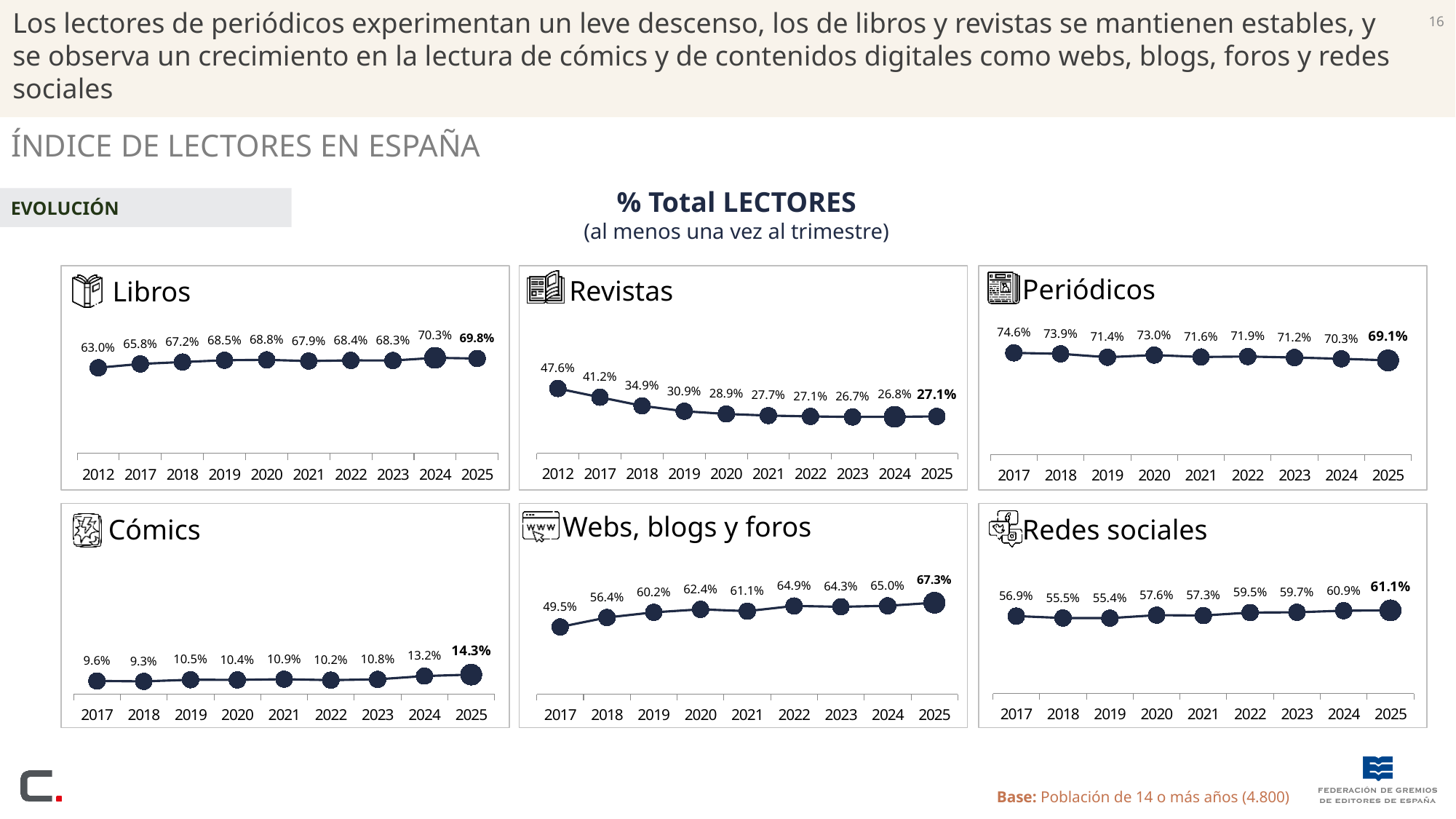
How many data points are plotted in the Libros chart? 10 In the Redes sociales chart, which is larger, the value for 2019 or the value for 2020? 2020 In the Revistas chart, do the values generally rise or fall from 2012 to 2025? Fall In the Periódicos chart, which year has the highest value? 2017 What kind of chart is the Revistas chart? Line chart How many separate charts are shown on the slide? 6 How many data points are plotted in the Cómics chart? 9 In the Periódicos chart, what is the difference between the 2017 and 2025 values? 5.5 percentage points In the Cómics chart, which year has the lowest value? 2018 In the Revistas chart, what is the value for 2012? 47.6% In the Libros chart, what is the value for 2025? 69.8% In the Webs, blogs y foros chart, what is the difference between the 2025 and 2017 values? 17.8 percentage points